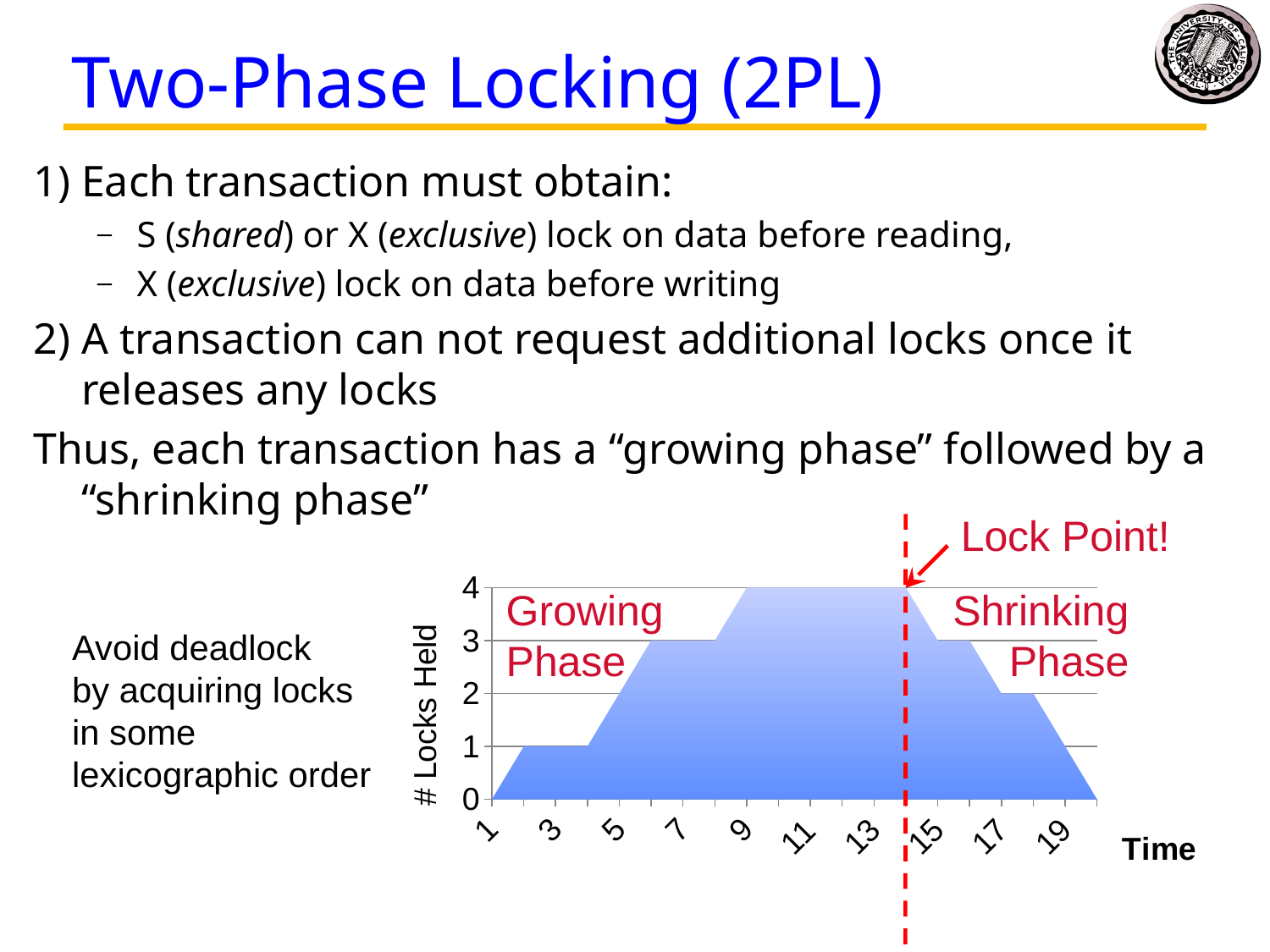
Is the number of locks held at time 3 greater or less than 2? less How many tick labels are shown on the horizontal axis of the chart? 10 What is the label of the vertical axis of the chart? # Locks Held Is the number of locks held at time 7 greater or less than 2? greater Is the number of locks held at time 11 greater or less than 3? greater What is the minimum number of locks held shown in the chart? 0 What is the label of the horizontal axis of the chart? Time Does the number of locks held rise or fall between time 15 and time 19? fall Does the number of locks held rise or fall between time 1 and time 9? rise What is the maximum number of locks held shown in the chart? 4 What kind of chart is shown on the slide? area chart